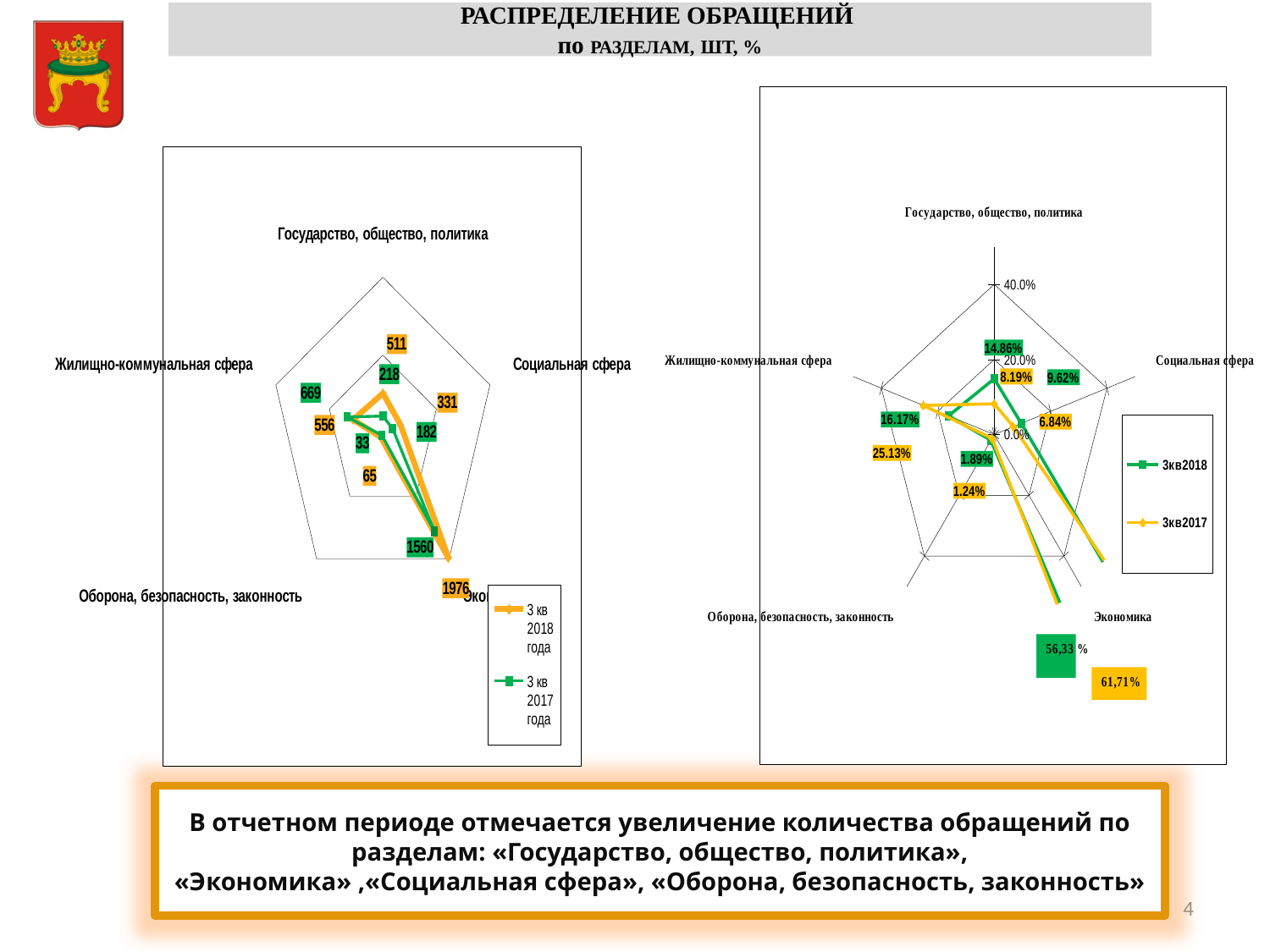
On the right chart, what is the difference between the 3кв2018 and 3кв2017 values for Государство, общество, политика? 6.67% On the left chart, what is the difference between the 3 кв 2018 года and 3 кв 2017 года values for Экономика? 416 On the right chart, what is the value for Жилищно-коммунальная сфера for the series 3кв2018? 16.17% On the left chart, what is the value for Государство, общество, политика for the series 3 кв 2017 года? 218 On the left chart, for Жилищно-коммунальная сфера, which series has the larger value: 3 кв 2018 года or 3 кв 2017 года? 3 кв 2017 года On the right chart, what is the value for Экономика for the series 3кв2017? 61,71% On the left chart, which category has the highest value for the series 3 кв 2018 года? Экономика How many series does the legend of the right chart list? 2 On the left chart, what is the value for Экономика for the series 3 кв 2018 года? 1976 What type of chart is the left chart? Radar chart On the left chart, which category has the lowest value for the series 3 кв 2017 года? Оборона, безопасность, законность On the right chart, what is the value for Оборона, безопасность, законность for the series 3кв2018? 1.89%